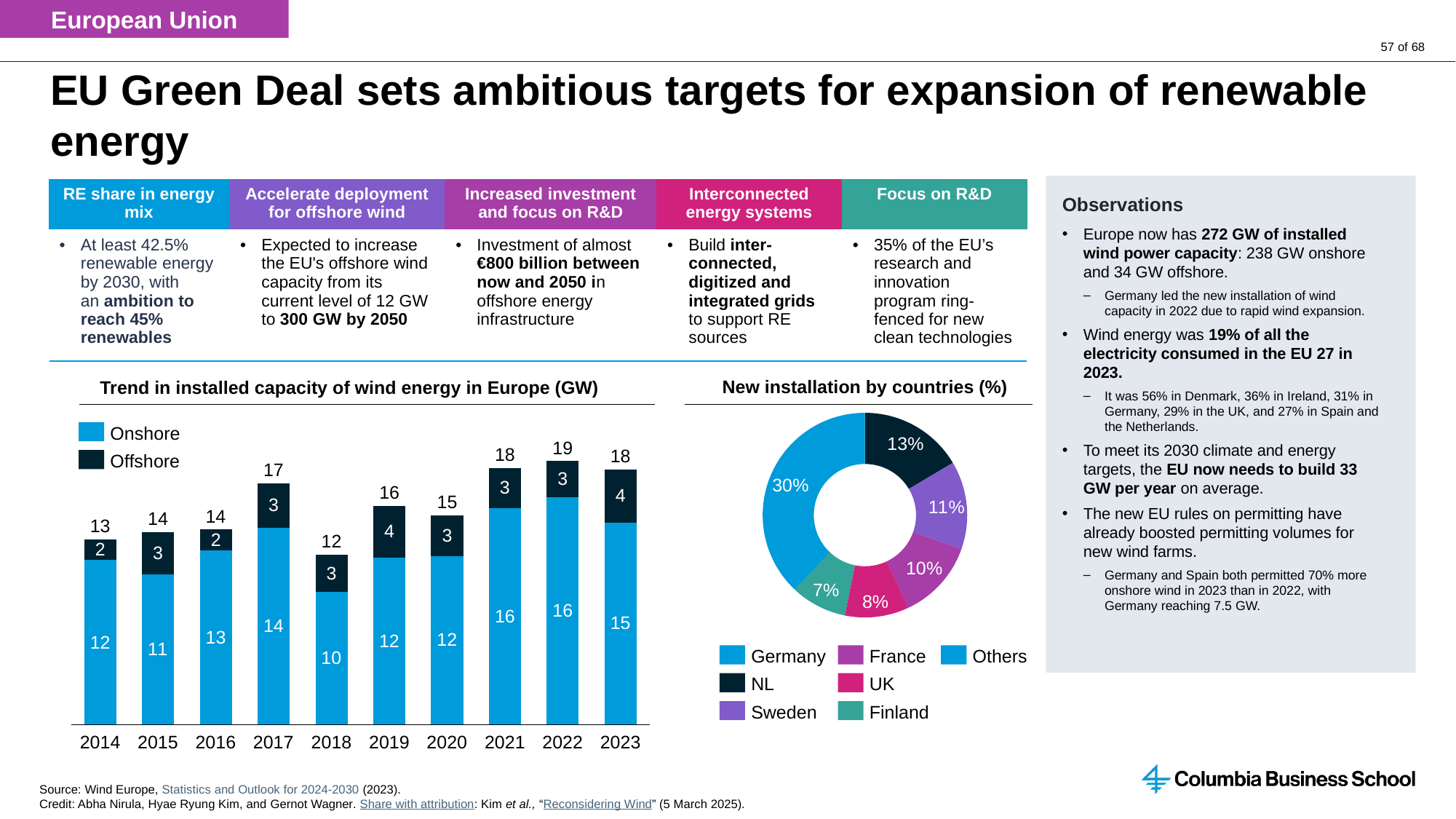
In the chart 'Trend in installed capacity of wind energy in Europe (GW)', how many years are shown on the x axis? 10 What kind of chart is 'Trend in installed capacity of wind energy in Europe (GW)'? Stacked bar chart In the chart 'Trend in installed capacity of wind energy in Europe (GW)', what is the offshore value for 2023? 4 In the chart 'New installation by countries (%)', what share is shown for NL? 13% In the chart 'Trend in installed capacity of wind energy in Europe (GW)', what is the onshore value for 2018? 10 In the chart 'Trend in installed capacity of wind energy in Europe (GW)', what is the difference between the total for 2021 and the total for 2014? 5 In the chart 'Trend in installed capacity of wind energy in Europe (GW)', how many series does the legend list? 2 In the chart 'Trend in installed capacity of wind energy in Europe (GW)', what is the total installed capacity for 2022? 19 In the chart 'New installation by countries (%)', what share is shown for Finland? 7% In the chart 'Trend in installed capacity of wind energy in Europe (GW)', which year has the highest total installed capacity? 2022 In the chart 'Trend in installed capacity of wind energy in Europe (GW)', which year has the lowest total installed capacity? 2018 In the chart 'New installation by countries (%)', which is larger, the share for Sweden or the share for UK? Sweden